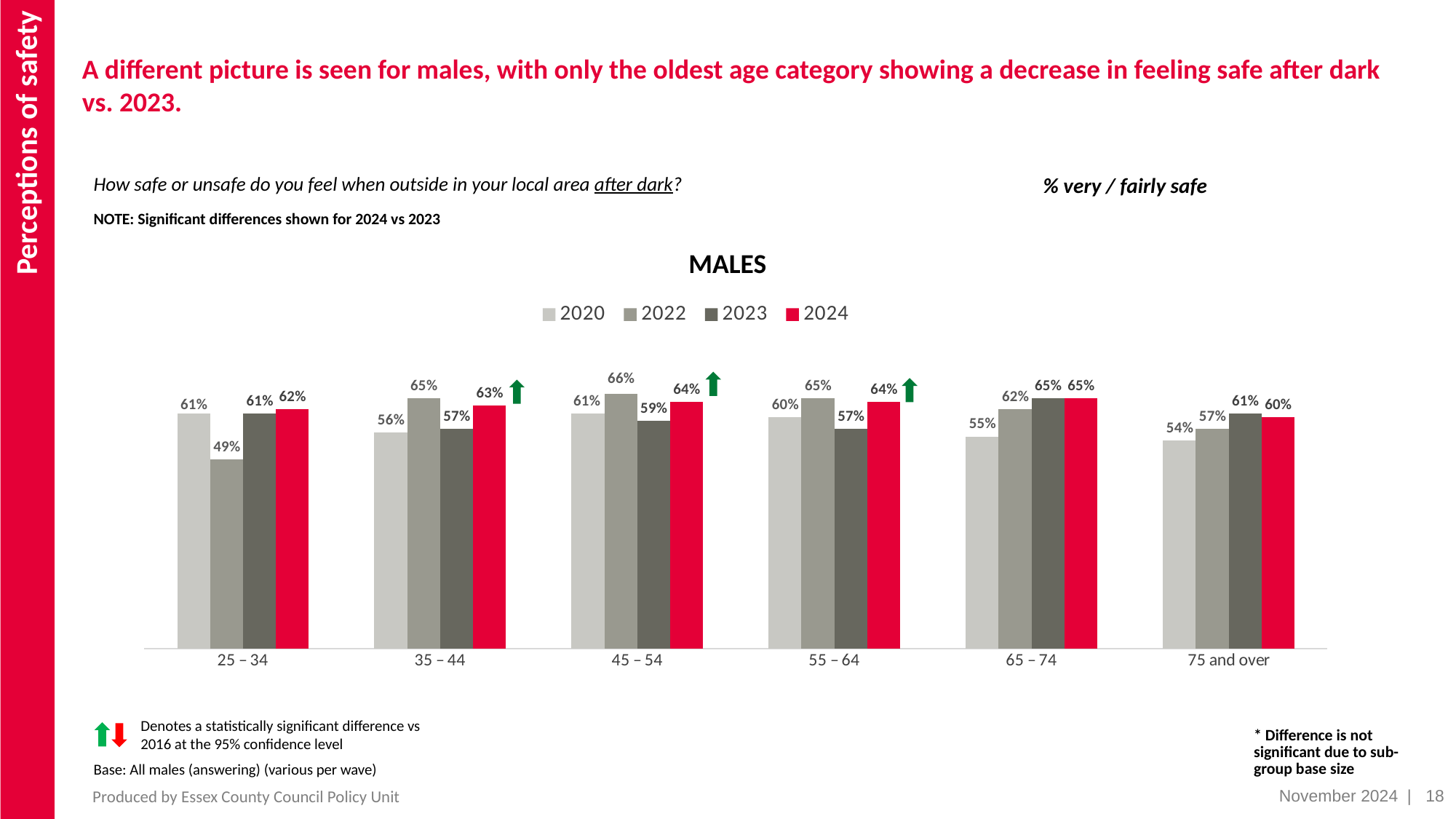
What kind of chart is shown on the slide? Bar chart What is the 2024 value for the 25 – 34 age group? 62% What is the 2022 value for the 25 – 34 age group? 49% How many series does the legend list? 4 Which is larger for the 55 – 64 age group, the 2022 value or the 2023 value? 2022 What is the title of the chart? MALES What is the difference between the 2024 and 2023 values for the 35 – 44 age group? 6 percentage points What is the 2023 value for the 75 and over age group? 61% Which age group has the lowest 2020 value? 75 and over How many age groups are shown on the x axis? 6 What is the 2020 value for the 65 – 74 age group? 55% Which age group has the highest 2022 value? 45 – 54